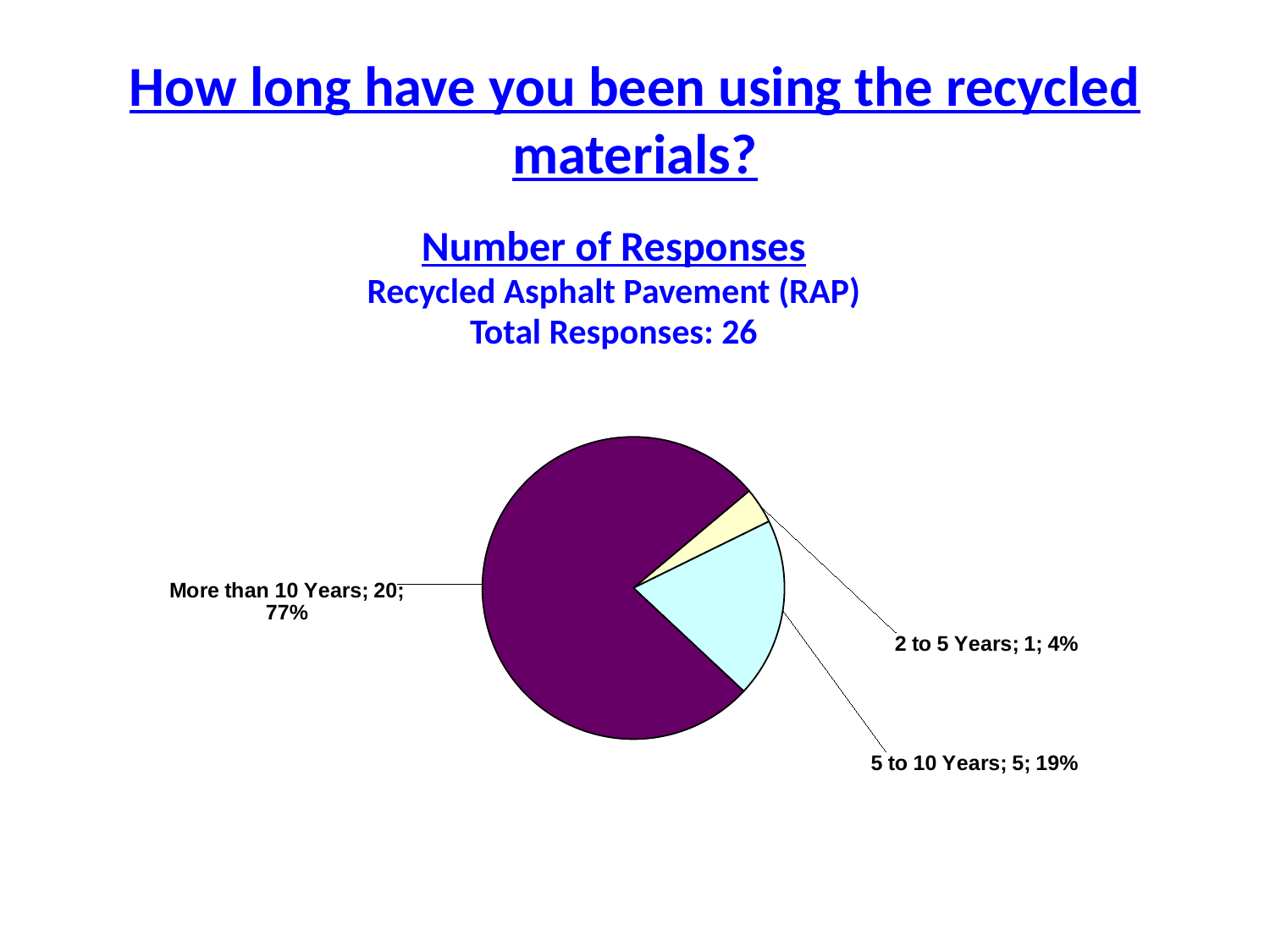
What share of the pie does the 'More than 10 Years' slice represent? 77% Which category has the largest number of responses? More than 10 Years What share of the pie does the '2 to 5 Years' slice represent? 4% Which category has the smallest number of responses? 2 to 5 Years What is the difference in responses between 'More than 10 Years' and '5 to 10 Years'? 15 How many responses are in the 'More than 10 Years' slice? 20 What kind of chart is shown on the slide? pie chart What share of the pie does the '5 to 10 Years' slice represent? 19% How many responses are in the '2 to 5 Years' slice? 1 How many responses are in the '5 to 10 Years' slice? 5 What is the total number of responses shown for the chart? 26 How many categories (slices) does the pie chart have? 3